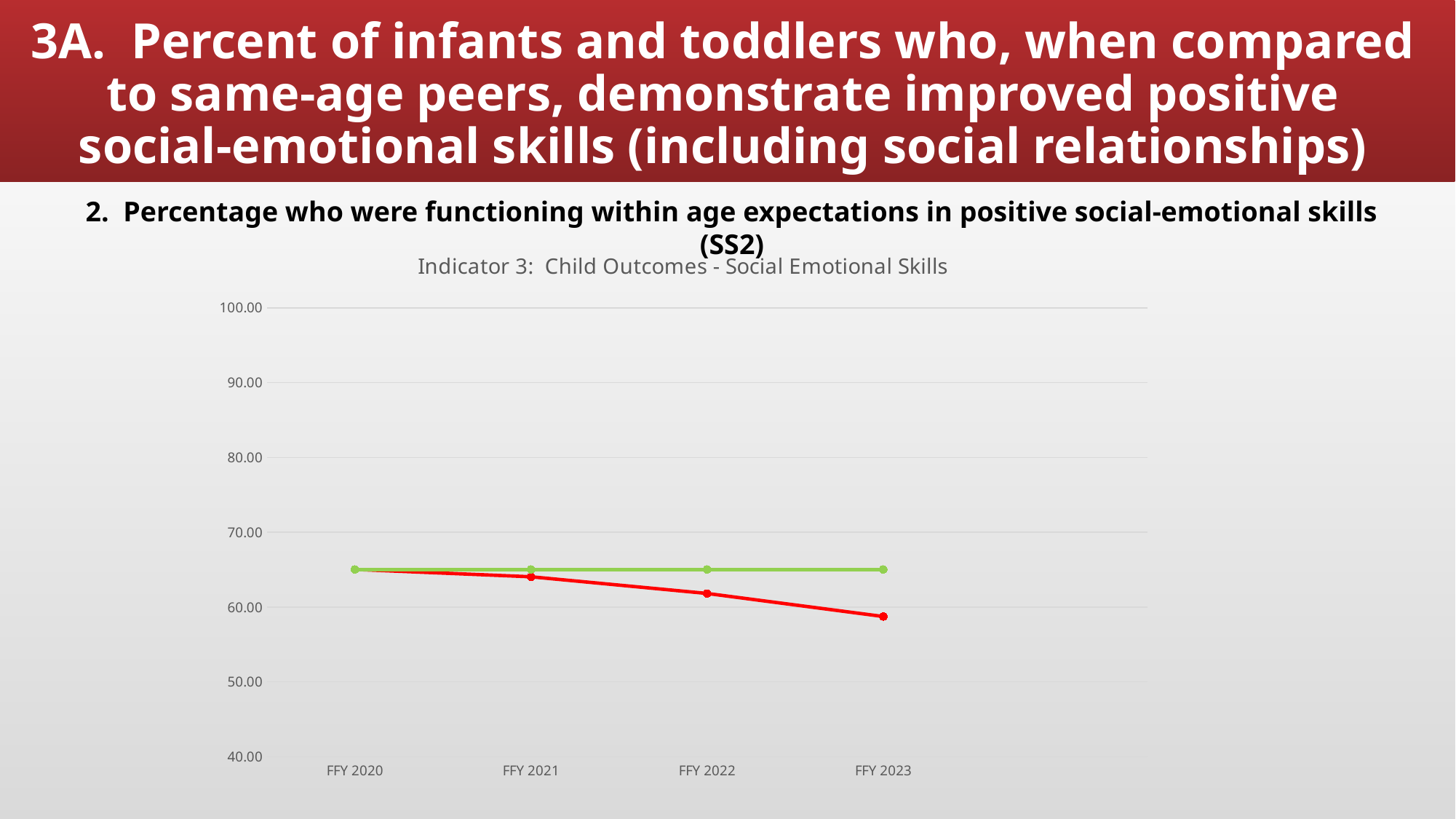
Is the value of the green line for FFY 2020 greater or less than 60? greater In which fiscal year does the red line reach its lowest value? FFY 2023 Is the value of the red line for FFY 2022 greater or less than 70? less What is the title of the chart? Indicator 3: Child Outcomes - Social Emotional Skills Does the red line rise or fall from FFY 2020 to FFY 2023? fall What is the lowest value shown on the vertical axis of the chart? 40.00 How many fiscal years are shown on the x axis of the chart? 4 What kind of chart is shown on the slide? line chart Is the value of the green line for FFY 2023 greater or less than 70? less At FFY 2023, which line has the higher value, the green line or the red line? green line How many lines are plotted on the chart? 2